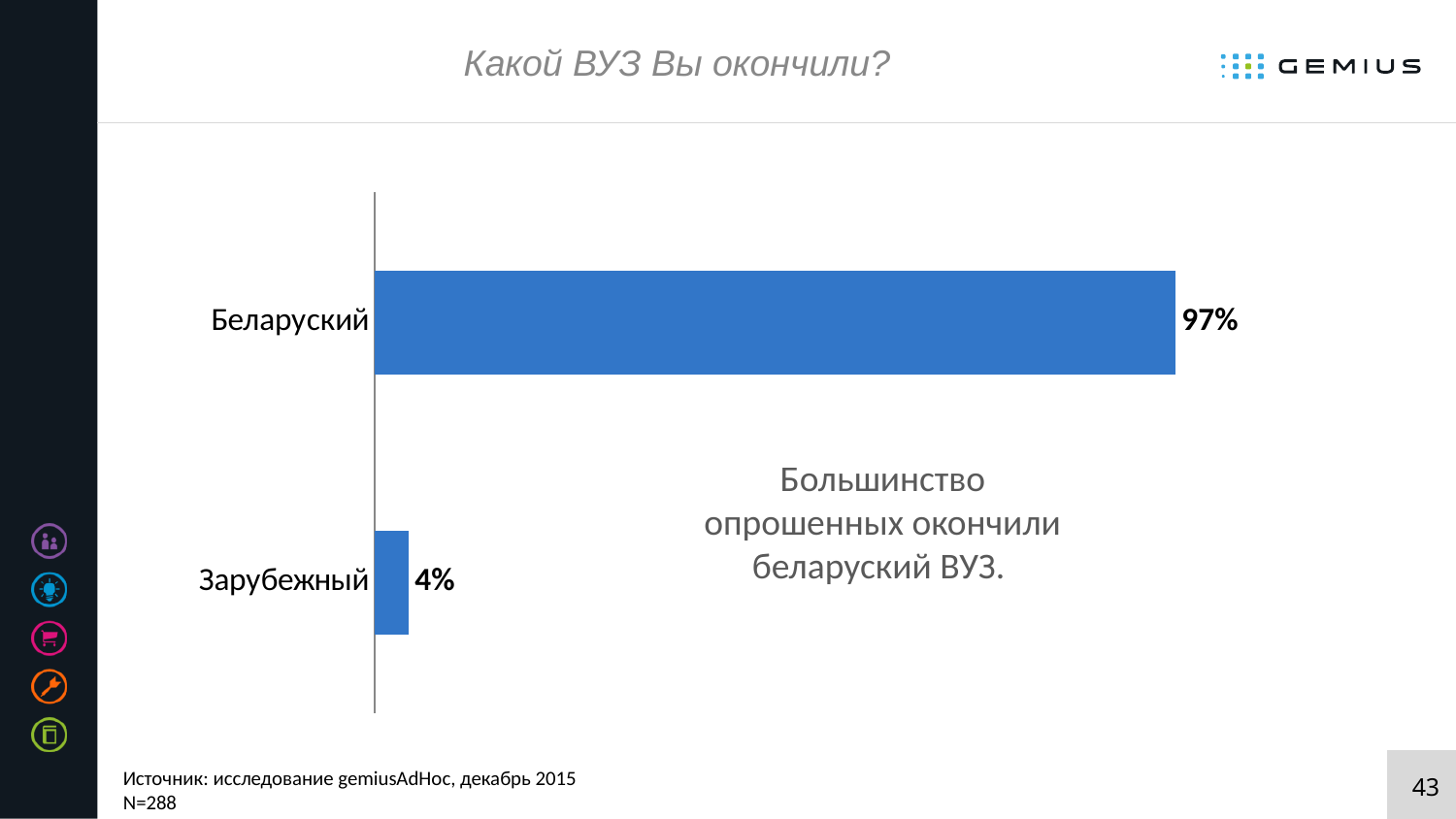
Which is larger, the value for Беларуский or the value for Зарубежный? Беларуский What is the difference between the values for Беларуский and Зарубежный? 93% What is the value for Зарубежный? 4% How many categories are shown in the chart? 2 Which category has the lowest value? Зарубежный What is the value for Беларуский? 97% What is the sample size (N) stated on the slide? N=288 What kind of chart is shown on the slide? Bar chart What is the title of the slide containing the chart? Какой ВУЗ Вы окончили? Which category has the highest value? Беларуский